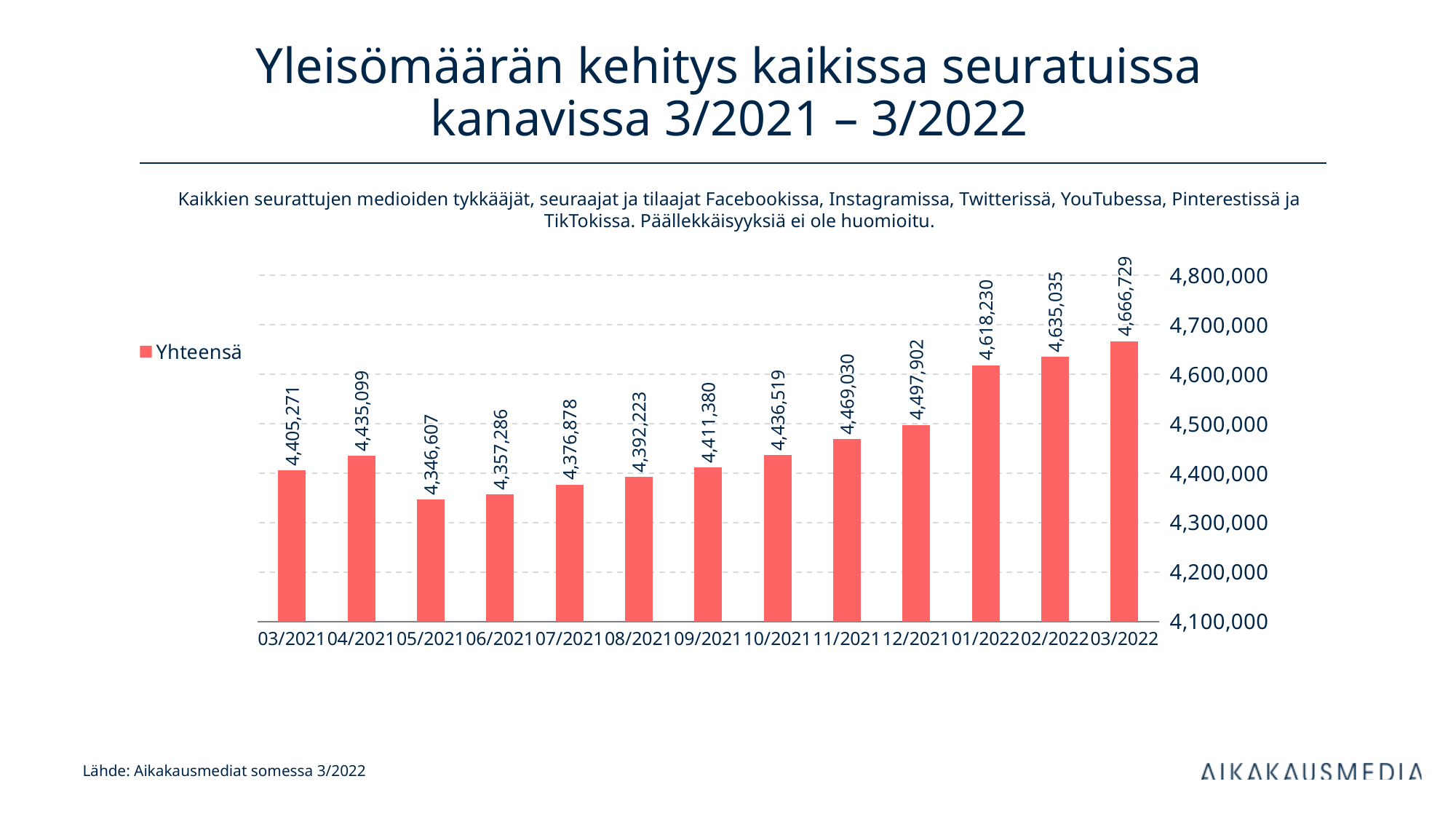
Which is larger, the value for 04/2021 or the value for 10/2021? 10/2021 Which month has the highest value? 03/2022 What is the difference between the values for 03/2022 and 03/2021? 261,458 What kind of chart is shown on the slide? bar chart What is the name of the series shown in the legend? Yhteensä Which month has the lowest value? 05/2021 What is the value for 03/2021? 4,405,271 What is the difference between the values for 01/2022 and 12/2021? 120,328 Is the value for 12/2021 greater or less than 4,500,000? less What is the value for 08/2021? 4,392,223 How many months are shown on the x axis? 13 What is the value for 01/2022? 4,618,230